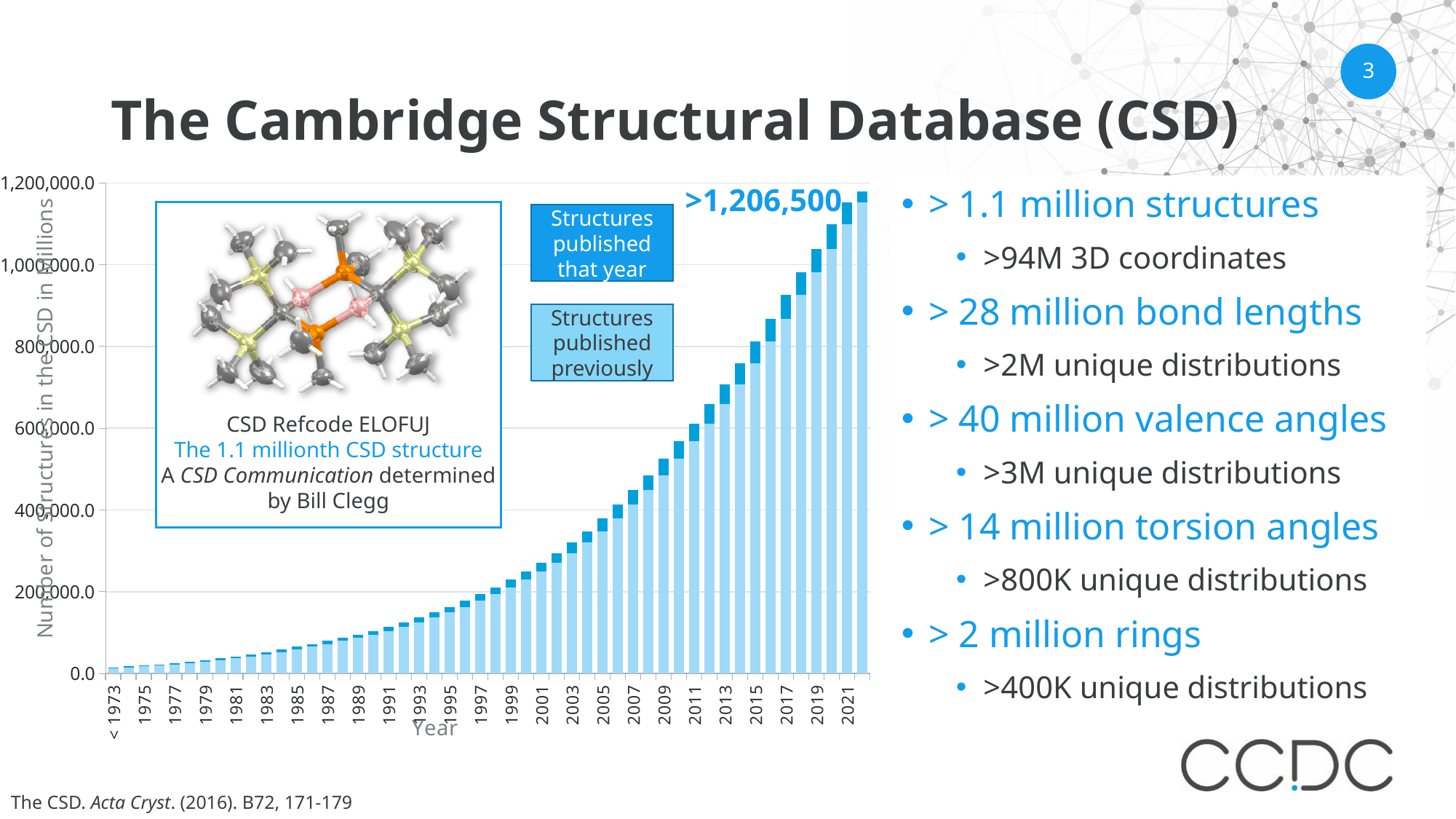
Which series is shown in the darker blue colour in the chart? Structures published that year What kind of chart is shown on the slide? bar chart Is the total value for 2013 greater or less than 600,000? greater Is the total value for 2009 greater or less than 600,000? less What value is labelled on the tallest bar of the chart? >1,206,500 Which year has a larger total number of structures, 2005 or 2015? 2015 Do the total number of structures rise or fall as the years increase along the x axis? rise Is the total value for 2021 greater or less than 1,000,000? greater What is the title of the chart's vertical axis? Number of Structures in the CSD in Millions Which year category has the lowest total number of structures? < 1973 How many series does the chart's legend list? 2